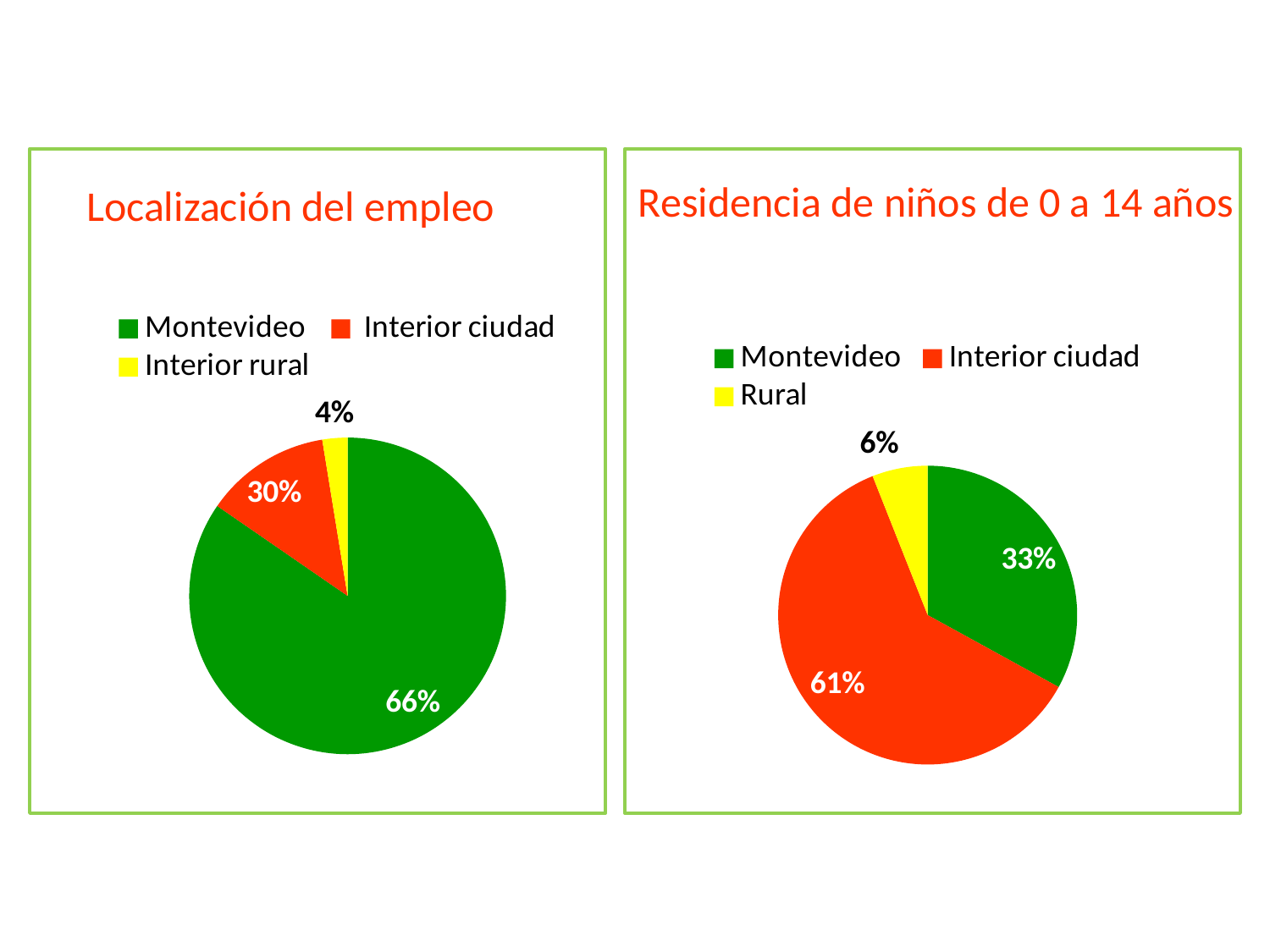
In the 'Residencia de niños de 0 a 14 años' chart, which category has the smallest slice? Rural What type of chart is the 'Localización del empleo' chart? Pie chart In the 'Localización del empleo' chart, what share does Interior rural have? 4% In the 'Residencia de niños de 0 a 14 años' chart, what share does Rural have? 6% In the 'Residencia de niños de 0 a 14 años' chart, what share does Interior ciudad have? 61% In the 'Localización del empleo' chart, what share does Montevideo have? 66% Which is larger in the 'Residencia de niños de 0 a 14 años' chart: Montevideo or Interior ciudad? Interior ciudad In the 'Localización del empleo' chart, what is the difference between the Montevideo and Interior ciudad shares? 36% In the 'Localización del empleo' chart, which category has the largest slice? Montevideo In the 'Localización del empleo' chart, what share does Interior ciudad have? 30% How many categories does the 'Residencia de niños de 0 a 14 años' chart show? 3 In the 'Residencia de niños de 0 a 14 años' chart, what share does Montevideo have? 33%